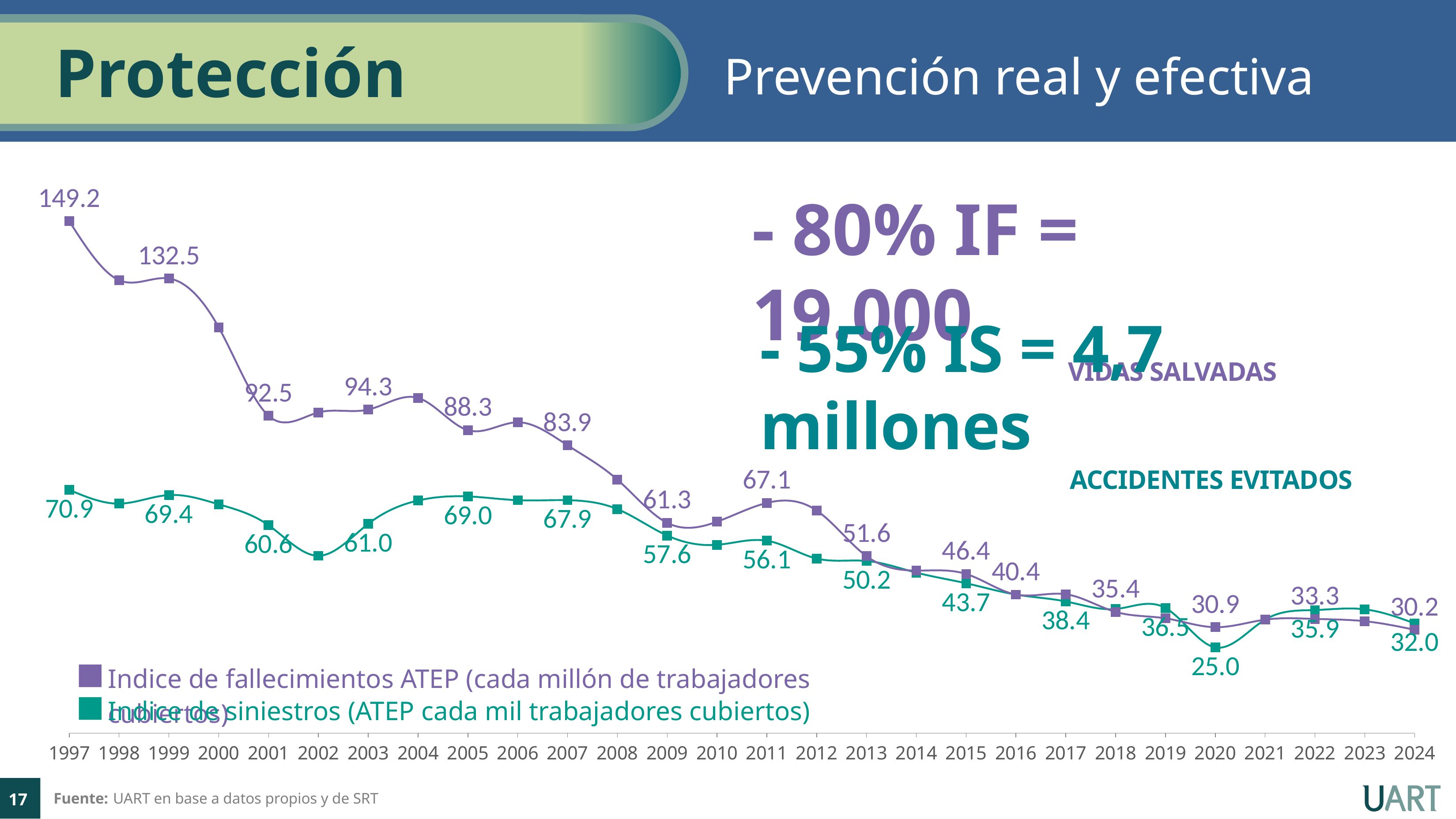
Does the Indice de fallecimientos ATEP series generally rise or fall from 1997 to 2024? Fall What kind of chart is shown on the slide? Line chart What is the value of the Indice de siniestros series in 1997? 70.9 How many years are shown along the x axis? 28 How many series does the legend list? 2 What is the difference between the Indice de fallecimientos ATEP values in 1997 and 2024? 119.0 What is the value of the Indice de fallecimientos ATEP series in 1997? 149.2 What is the value of the Indice de fallecimientos ATEP series in 2024? 30.2 Which series has the larger value in 1997, Indice de fallecimientos ATEP or Indice de siniestros? Indice de fallecimientos ATEP What is the value of the Indice de siniestros series in 2020? 25.0 In which year is the Indice de siniestros series at its lowest? 2020 In which year is the Indice de fallecimientos ATEP series at its highest? 1997